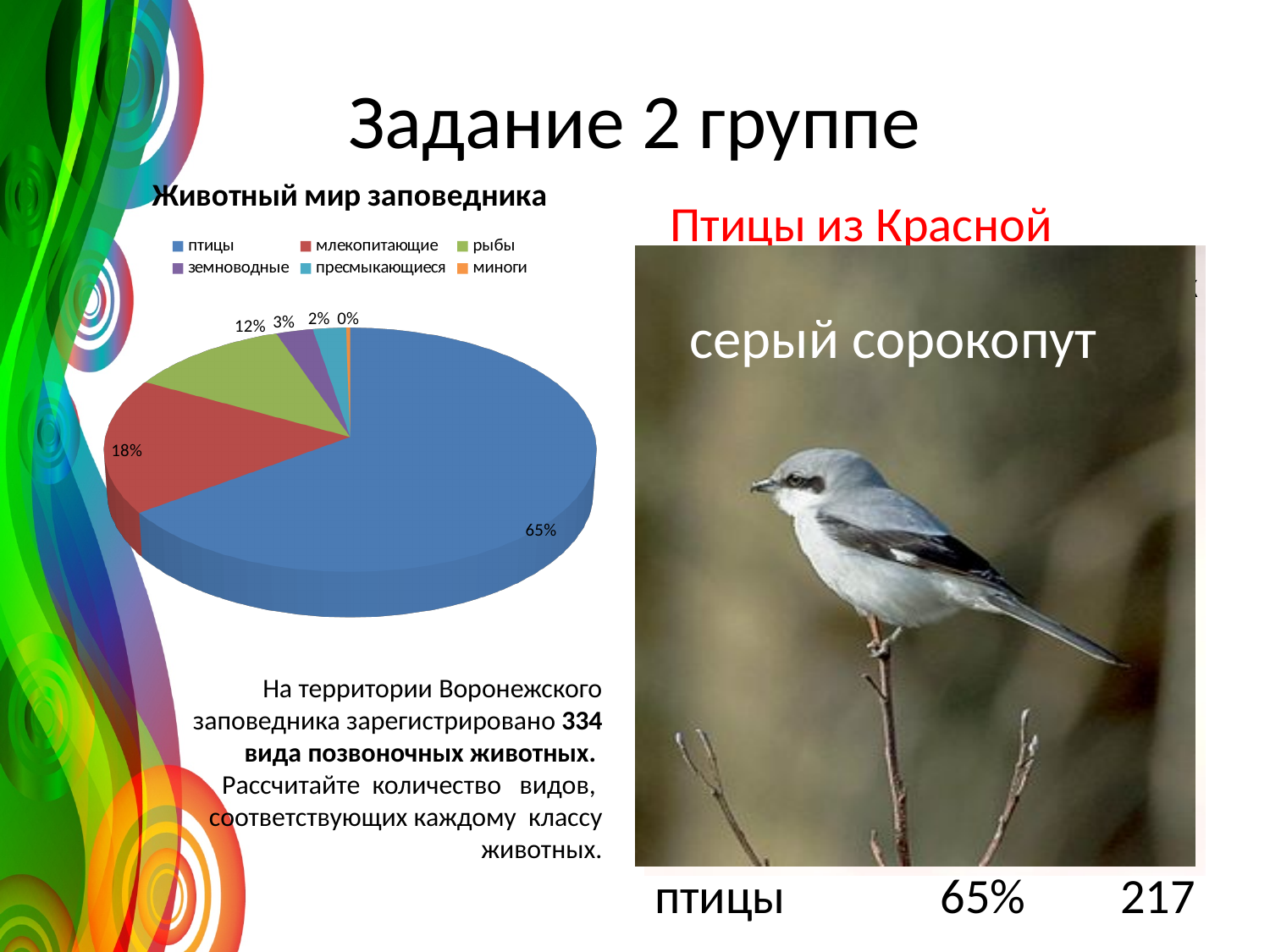
What kind of chart is shown under the title "Животный мир заповедника"? pie chart In the pie chart "Животный мир заповедника", what share is shown for млекопитающие? 18% Which category has the smallest slice in the pie chart "Животный мир заповедника"? миноги In the pie chart "Животный мир заповедника", how many percentage points larger is the share of птицы than the share of млекопитающие? 47% In the pie chart "Животный мир заповедника", what share is shown for земноводные? 3% In the pie chart "Животный мир заповедника", what share is shown for пресмыкающиеся? 2% In the pie chart "Животный мир заповедника", what share is shown for рыбы? 12% In the pie chart "Животный мир заповедника", which slice is larger: рыбы or земноводные? рыбы In the pie chart "Животный мир заповедника", what share is shown for миноги? 0% How many categories does the legend of the pie chart "Животный мир заповедника" list? 6 Which category has the largest slice in the pie chart "Животный мир заповедника"? птицы In the pie chart "Животный мир заповедника", what share is shown for птицы? 65%